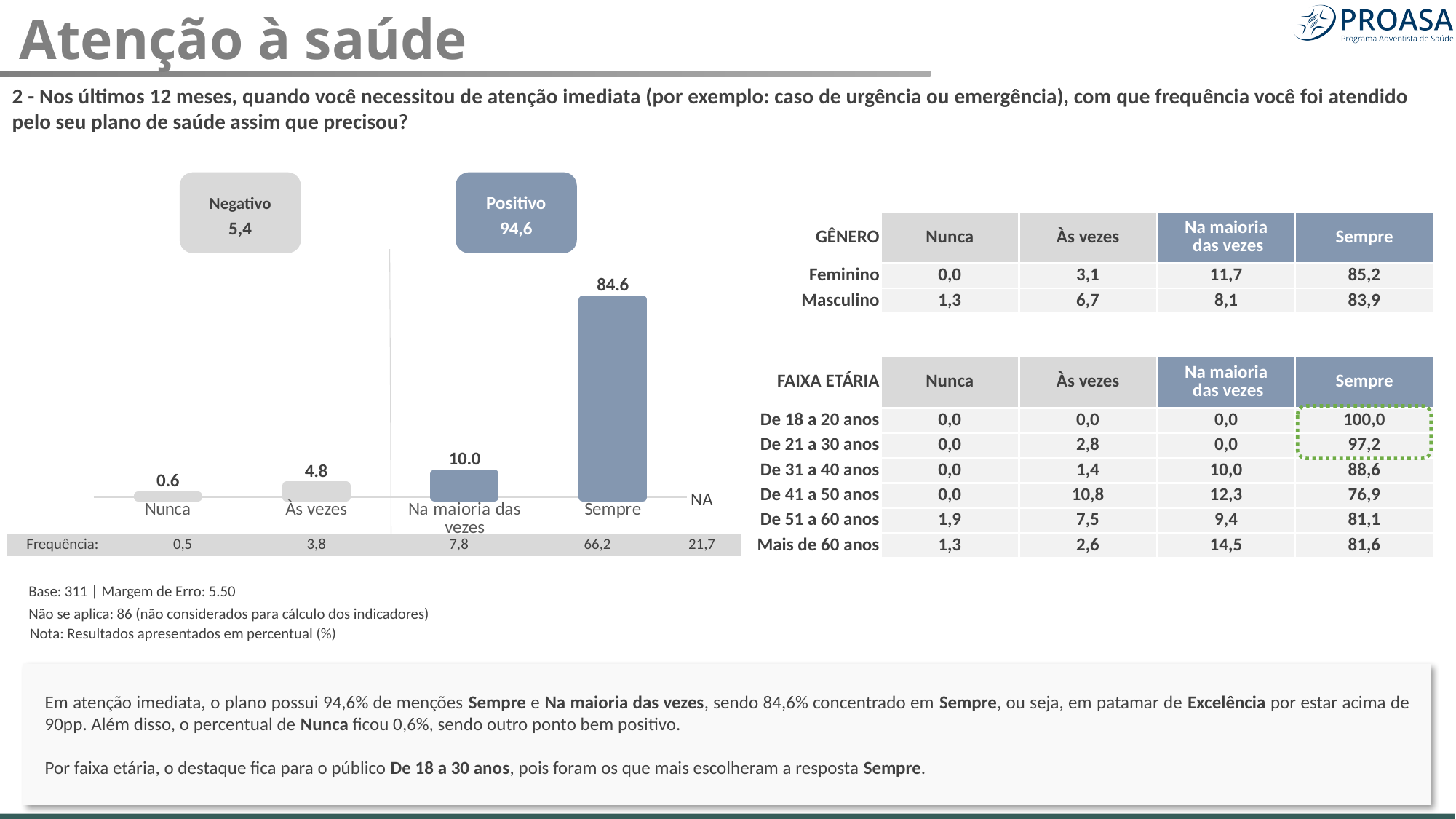
What is the value of the bar for Na maioria das vezes? 10.0 What value is shown in the Positivo box above the chart? 94,6 What is the value of the bar for Sempre? 84.6 Which is larger, the value for Às vezes or the value for Na maioria das vezes? Na maioria das vezes What kind of chart is shown on the slide? bar chart What is the difference between the values for Na maioria das vezes and Às vezes? 5.2 What is the value of the bar for Nunca? 0.6 What is the difference between the values for Sempre and Na maioria das vezes? 74.6 Do the bar values rise or fall from Nunca to Sempre along the x axis? rise Which category has the highest bar? Sempre What is the value of the bar for Às vezes? 4.8 Which category has the lowest bar? Nunca